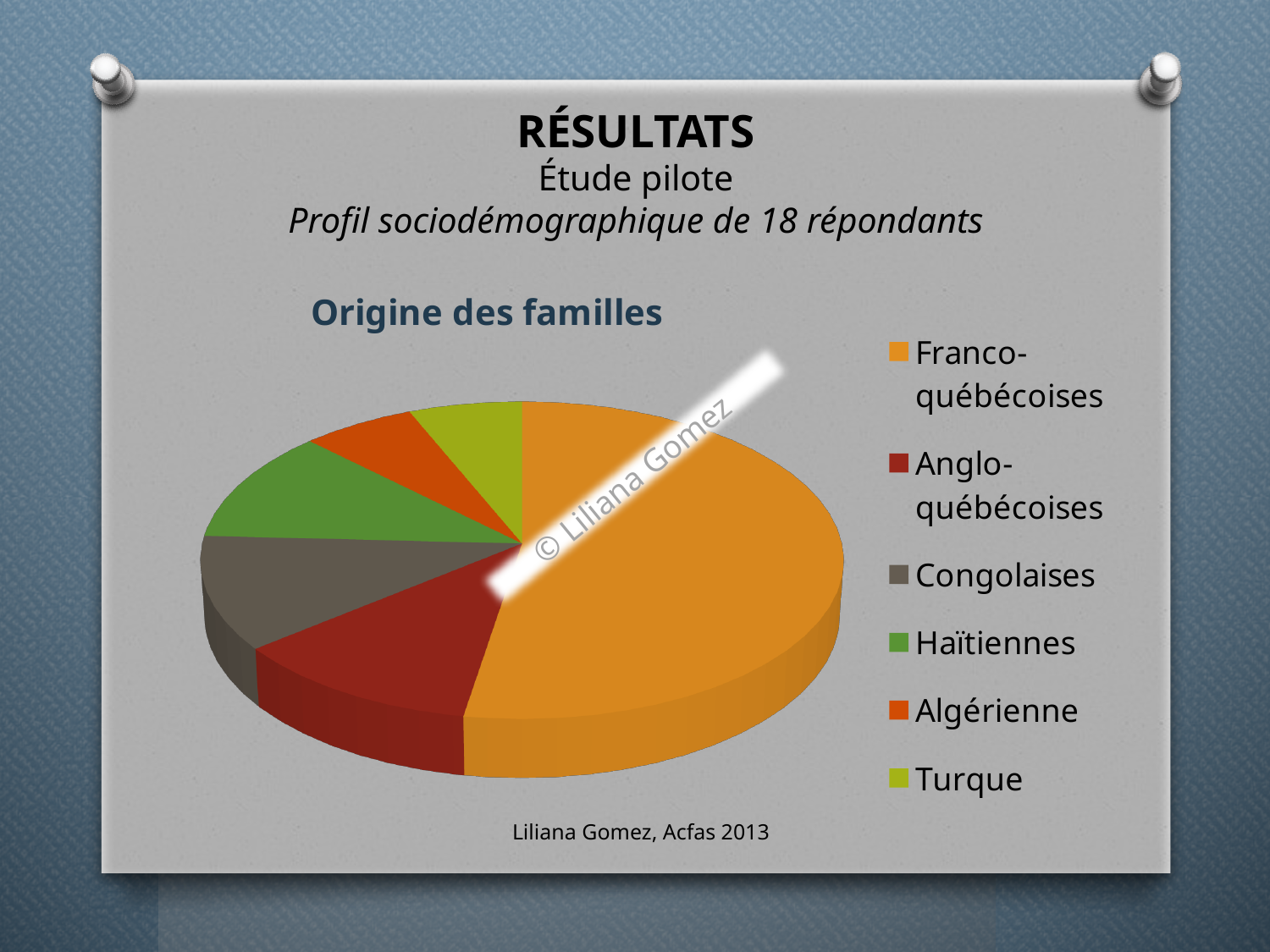
Which slice is larger, Anglo-québécoises or Turque? Anglo-québécoises How many categories does the pie chart show? 6 Which slice is larger, Franco-québécoises or Congolaises? Franco-québécoises Which category is listed last in the legend? Turque Which slice is larger, Haïtiennes or Algérienne? Haïtiennes What kind of chart is shown on the slide? pie chart Which category has the largest slice of the pie? Franco-québécoises What is the title of the chart? Origine des familles Which colour represents the Congolaises category in the legend? grey